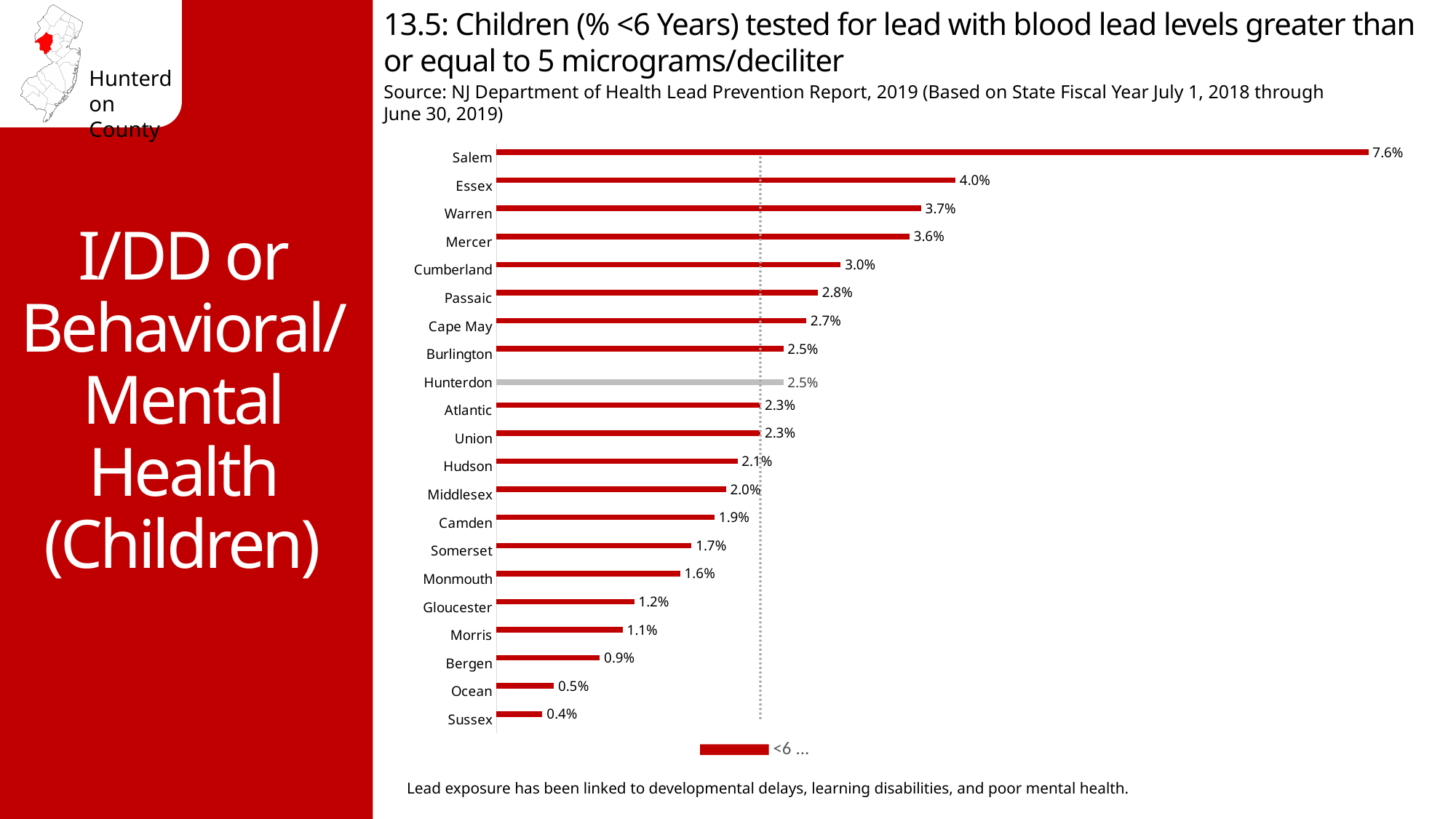
Which county has the highest value? Salem Which county's bar is shown in gray rather than red? Hunterdon What is the value for Hunterdon? 2.5% Which has a larger value, Warren or Cumberland? Warren Which county has the lowest value? Sussex How many counties are shown in the chart? 21 Which has a larger value, Bergen or Gloucester? Gloucester What is the value for Mercer? 3.6% What is the difference between the values for Hunterdon and Sussex? 2.1% What kind of chart is shown on the slide? Bar chart What is the difference between the values for Salem and Essex? 3.6% What is the value for Salem? 7.6%